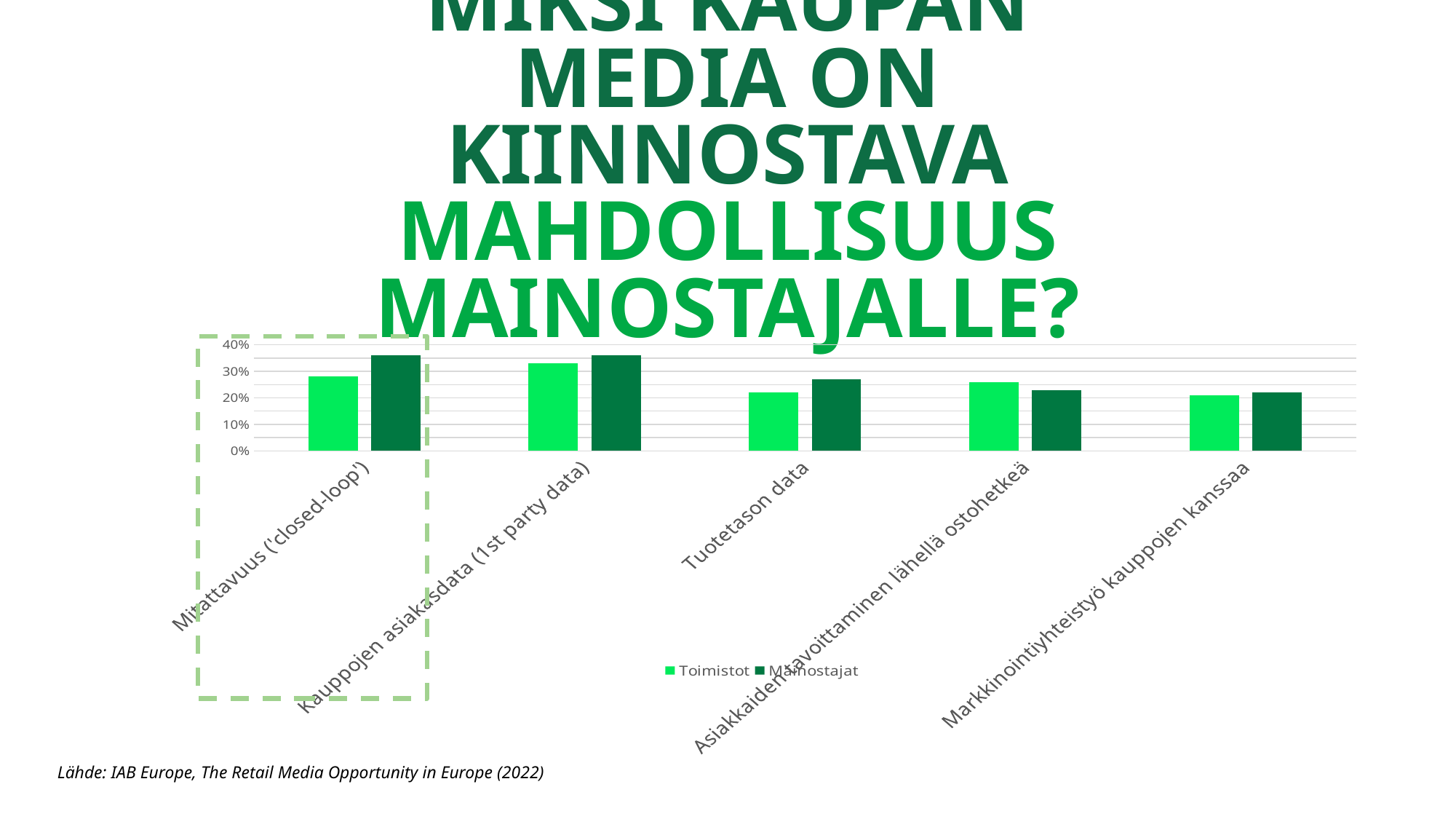
How many categories are shown on the x axis of the chart? 5 Which category has the highest Toimistot value? Kauppojen asiakasdata (1st party data) Is the Toimistot value for Kauppojen asiakasdata (1st party data) greater or less than 20%? greater Is the Mainostajat value for Mitattavuus ('closed-loop') greater or less than 30%? greater Is the Toimistot value for Tuotetason data greater or less than 30%? less What are the two series named in the chart's legend? Toimistot and Mainostajat How many series does the chart's legend list? 2 For Mitattavuus ('closed-loop'), which series has the larger value, Toimistot or Mainostajat? Mainostajat What kind of chart is shown on the slide? Bar chart For Asiakkaiden tavoittaminen lähellä ostohetkeä, which series has the larger value, Toimistot or Mainostajat? Toimistot For Tuotetason data, which series has the larger value, Toimistot or Mainostajat? Mainostajat